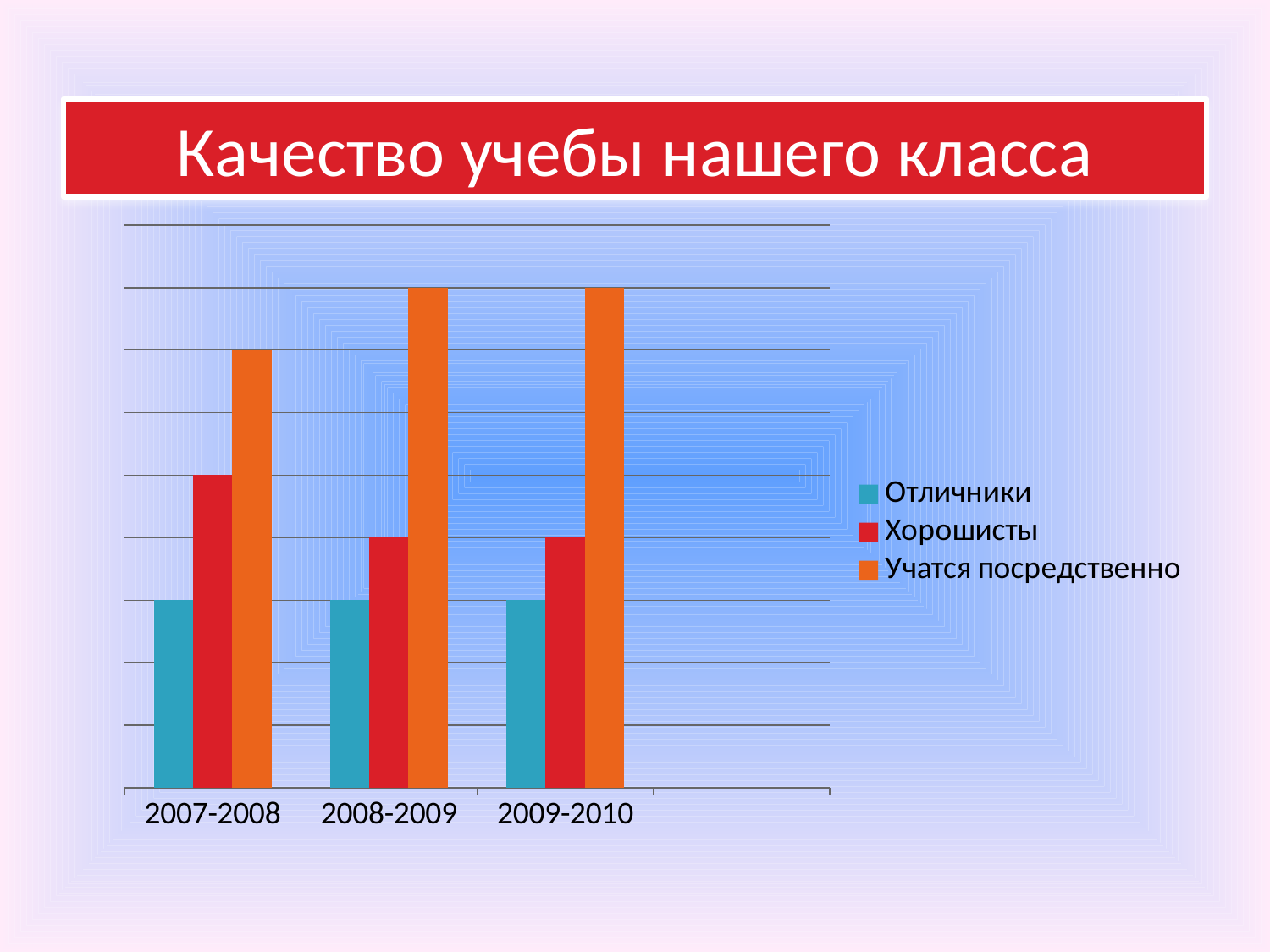
What kind of chart is shown on the slide? bar chart Does the Хорошисты series rise or fall from 2007-2008 to 2008-2009? fall In 2009-2010, which series has the shortest bar? Отличники Is the Учатся посредственно bar larger in 2007-2008 or in 2009-2010? 2009-2010 Which series is shown in orange in the legend? Учатся посредственно Is the Хорошисты bar larger in 2007-2008 or in 2008-2009? 2007-2008 How many series does the legend list? 3 What is the title of the slide? Качество учебы нашего класса In 2007-2008, which series has the tallest bar? Учатся посредственно In 2007-2008, which series has the shortest bar? Отличники Does the Учатся посредственно series rise or fall from 2007-2008 to 2008-2009? rise How many school years (categories) are shown on the x axis? 3